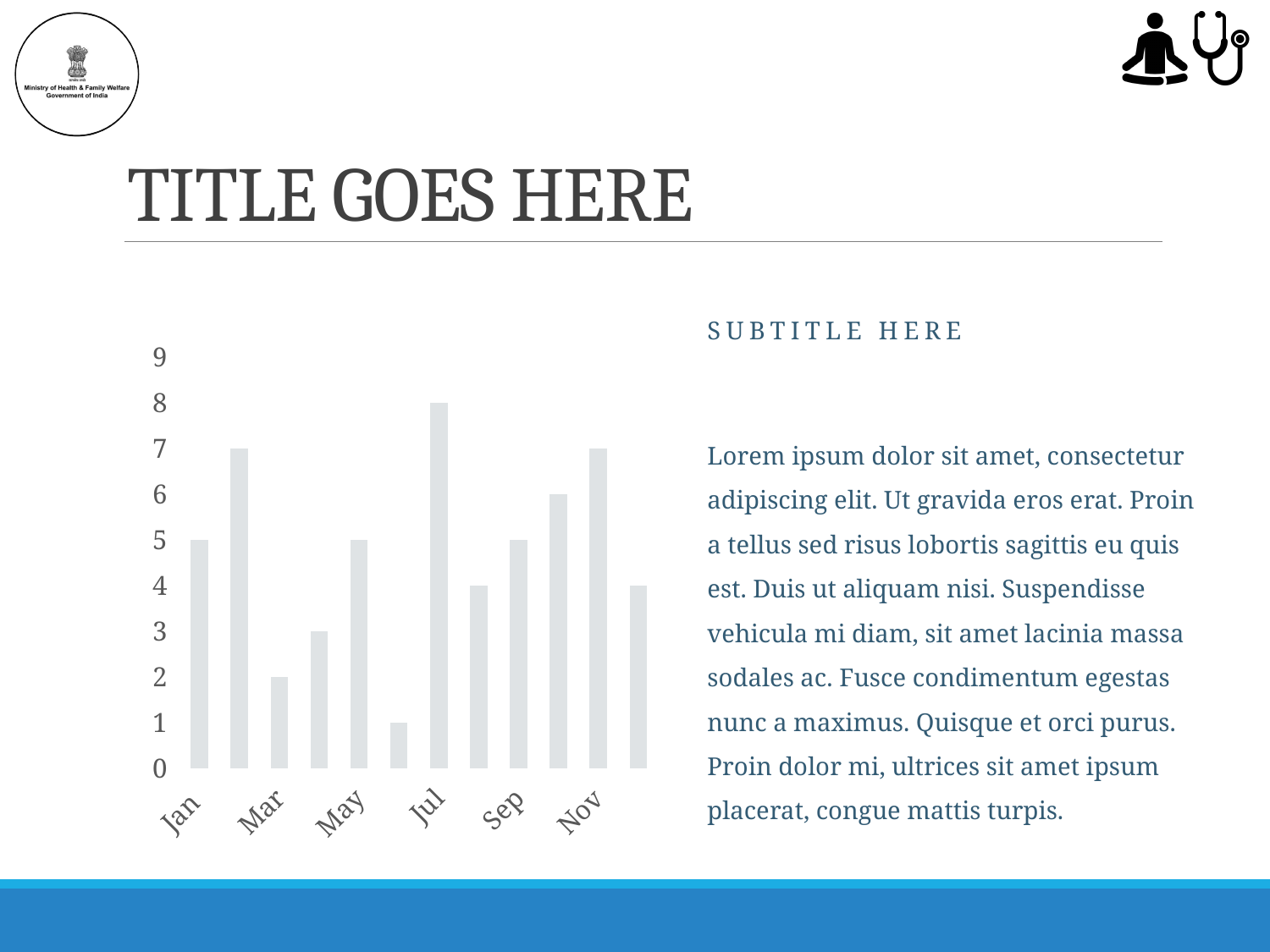
What is the value for Jul? 8 How many bars are plotted in the chart? 12 Which is larger, the value for Nov or the value for May? Nov Which month has the highest bar? Jul What is the highest value shown on the vertical axis? 9 What is the value for Nov? 7 What type of chart is shown on the slide? bar chart What is the difference between the values for Jul and Mar? 6 What is the value for Jan? 5 What is the value for Mar? 2 Is the value for Jul greater or less than 6? greater What is the value for Sep? 5